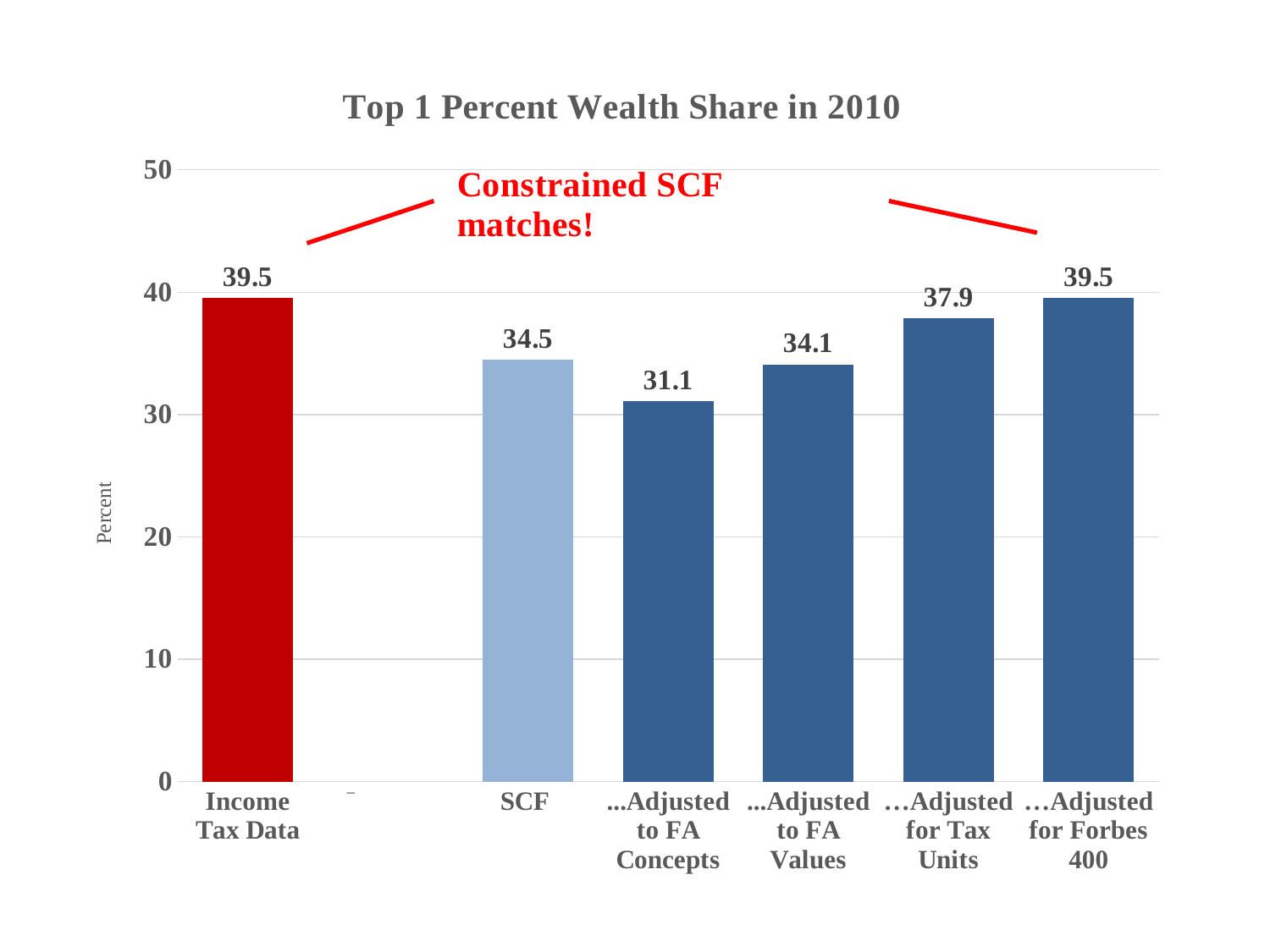
Which category has the lowest value? ...Adjusted to FA Concepts What is the value for ...Adjusted for Tax Units? 37.9 What is the value for ...Adjusted to FA Concepts? 31.1 What kind of chart is shown on the slide? bar chart From ...Adjusted to FA Concepts to ...Adjusted for Forbes 400, do the values rise or fall? rise What is the difference between the ...Adjusted for Forbes 400 value and the ...Adjusted for Tax Units value? 1.6 What is the value for SCF? 34.5 Which is larger, the value for ...Adjusted for Tax Units or the value for SCF? ...Adjusted for Tax Units What is the value for Income Tax Data? 39.5 What is the difference between the Income Tax Data value and the SCF value? 5.0 What is the title of the chart? Top 1 Percent Wealth Share in 2010 Is the value for ...Adjusted to FA Concepts greater or less than 30? greater